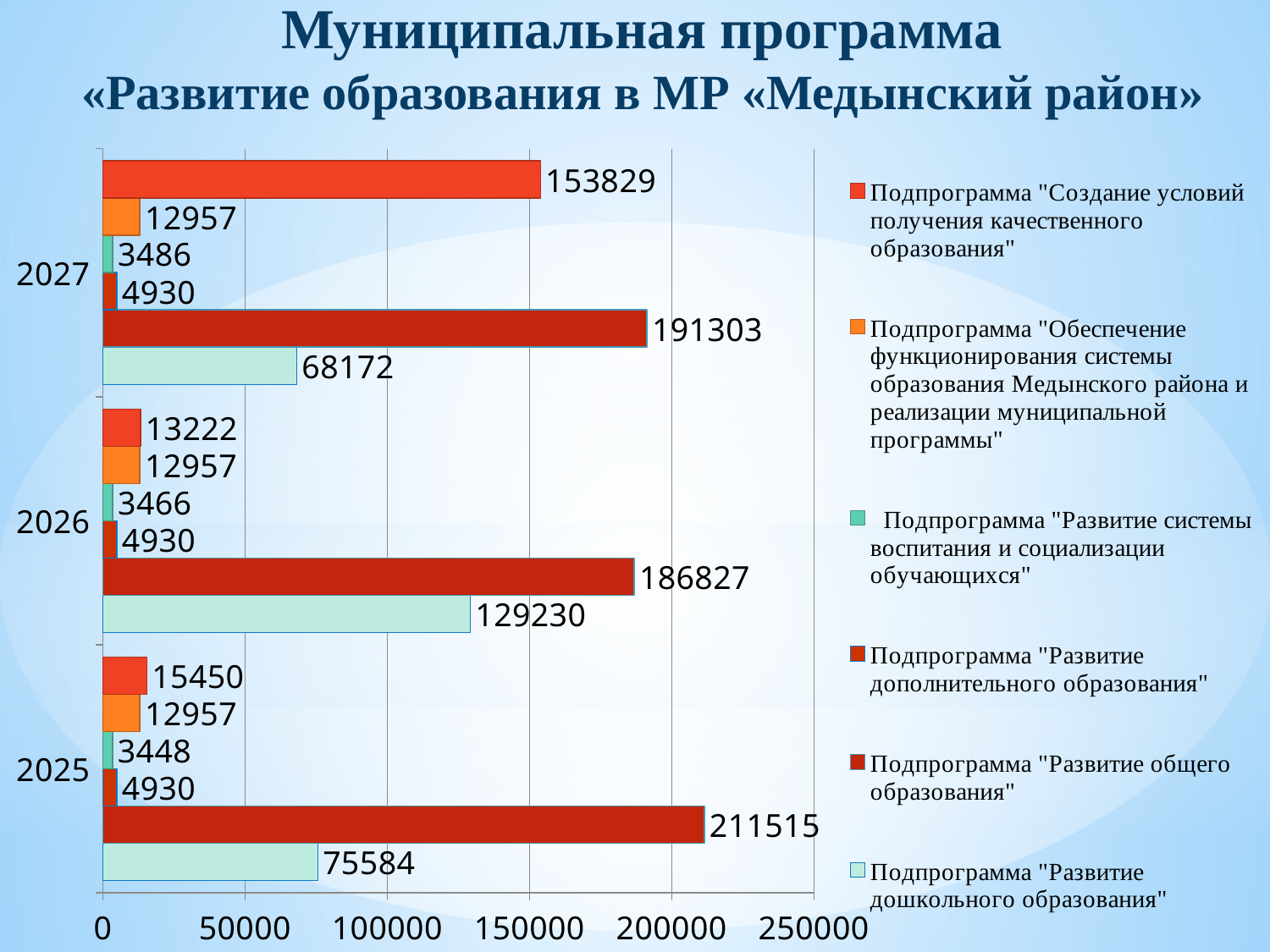
Is the 2027 value for "Подпрограмма "Развитие общего образования"" greater or less than 150000? greater Which is larger: the 2026 value for "Подпрограмма "Развитие дошкольного образования"" or the 2025 value for the same subprogram? 2026 In which year is the value for "Подпрограмма "Развитие дошкольного образования"" the lowest? 2027 What is the value for "Подпрограмма "Развитие дошкольного образования"" in 2026? 129230 What kind of chart is shown on the slide? bar chart What is the value for "Подпрограмма "Развитие общего образования"" in 2025? 211515 How many years are shown on the vertical axis? 3 What is the value for "Подпрограмма "Развитие системы воспитания и социализации обучающихся"" in 2025? 3448 In which year is the value for "Подпрограмма "Развитие общего образования"" the highest? 2025 How many series does the legend list? 6 What is the value for "Подпрограмма "Создание условий получения качественного образования"" in 2027? 153829 What is the difference between the 2025 and 2027 values for "Подпрограмма "Развитие общего образования""? 20212